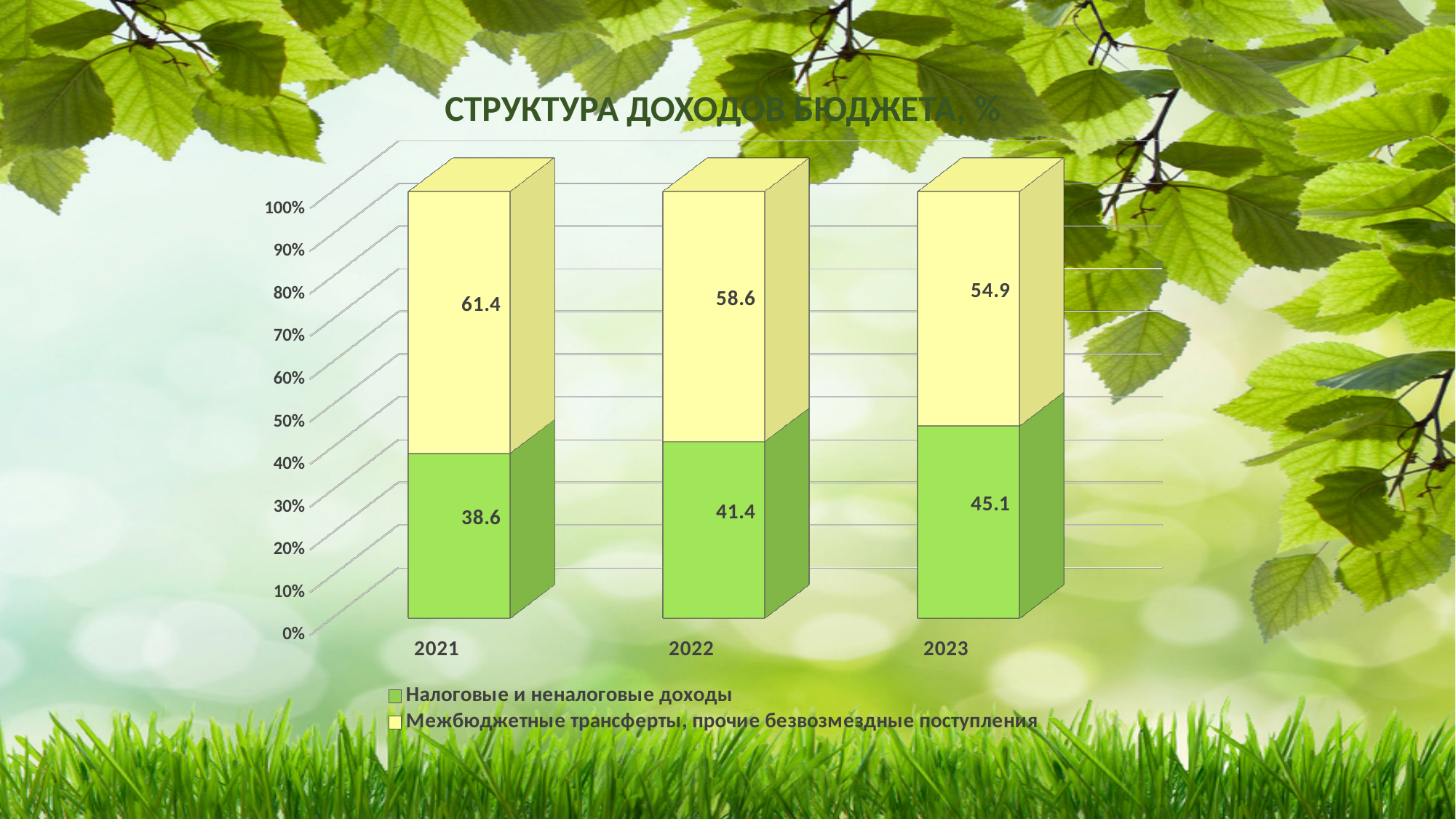
In which year is Налоговые и неналоговые доходы highest? 2023 How many years are shown on the x axis? 3 What is the difference between Налоговые и неналоговые доходы in 2023 and in 2021? 6.5 What is the title of the chart? СТРУКТУРА ДОХОДОВ БЮДЖЕТА, % Which is larger in 2022: Налоговые и неналоговые доходы or Межбюджетные трансферты, прочие безвозмездные поступления? Межбюджетные трансферты, прочие безвозмездные поступления What is the value of Налоговые и неналоговые доходы for 2021? 38.6 Does the value of Налоговые и неналоговые доходы rise or fall from 2021 to 2023? Rise What is the value of Межбюджетные трансферты, прочие безвозмездные поступления for 2023? 54.9 What kind of chart is shown on the slide? Stacked bar chart How many series does the legend list? 2 In which year is Межбюджетные трансферты, прочие безвозмездные поступления lowest? 2023 What is the value of Межбюджетные трансферты, прочие безвозмездные поступления for 2022? 58.6